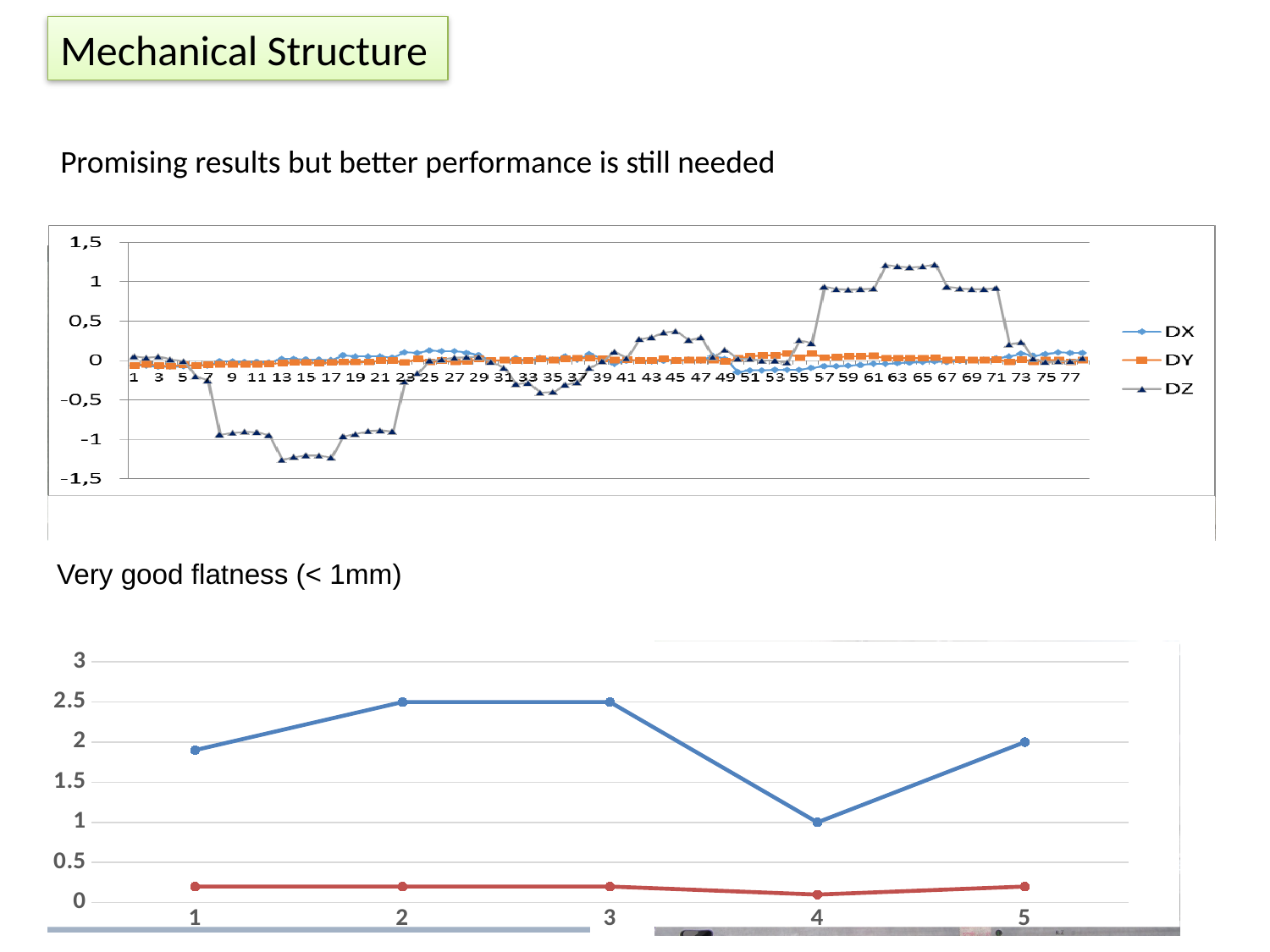
In the top chart, is the DZ value at x = 57 greater or less than 0.5? greater What kind of chart is the top chart on the slide? line chart In the top chart, how many series does the legend list? 3 In the bottom chart, does the blue line rise or fall between x = 3 and x = 4? fall In the top chart, is the DZ value at x = 13 greater or less than -1? less In the bottom chart, at which x value does the blue line reach its lowest point? 4 In the bottom chart, how many points are plotted along the x axis for each line? 5 In the top chart, what are the names of the series in the legend? DX, DY, DZ In the top chart, which series has the largest swings away from zero? DZ In the top chart, is the DZ value at x = 65 greater or less than 1? greater What kind of chart is the bottom chart on the slide? line chart